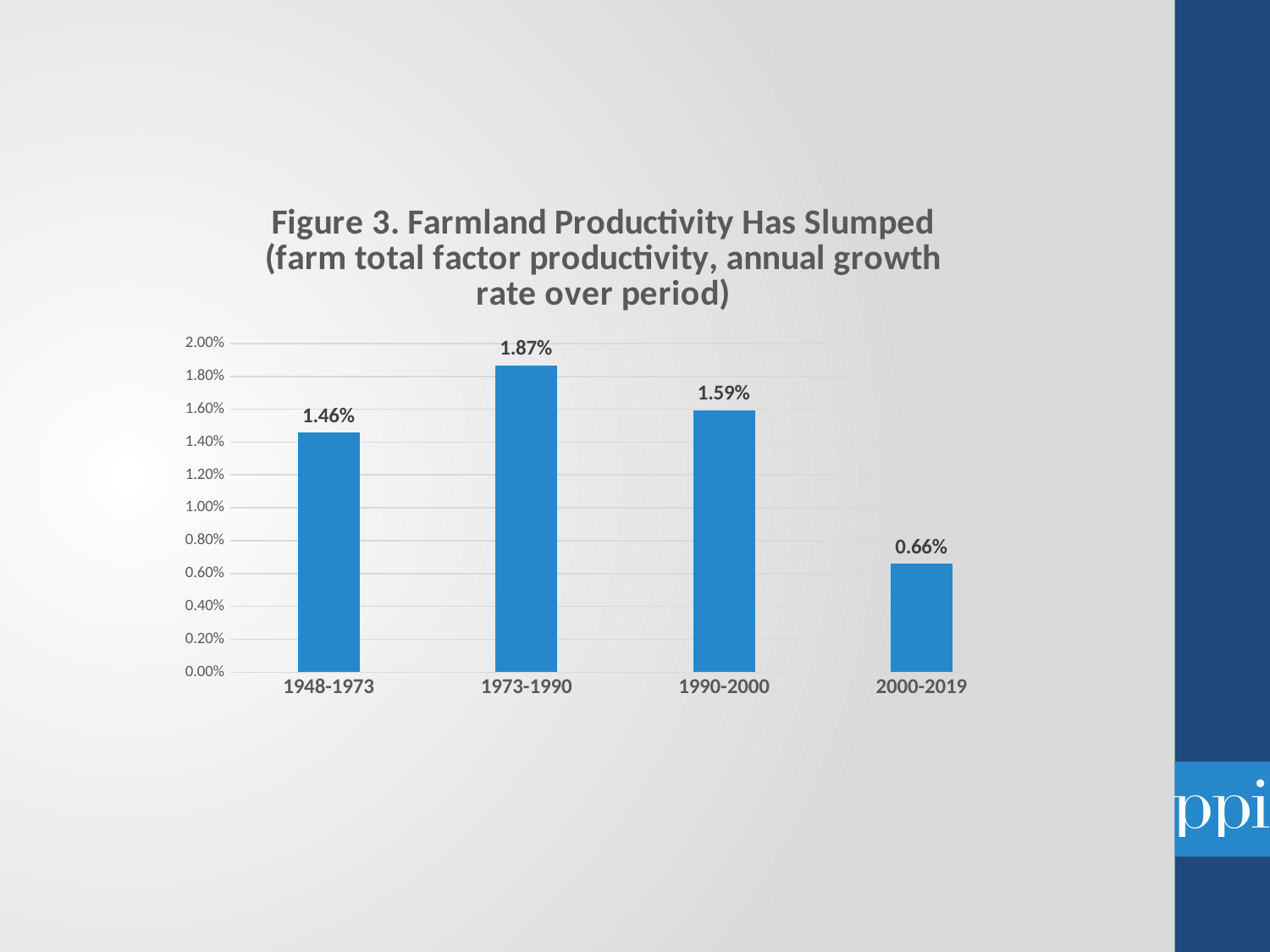
Is the value for 2000-2019 greater or less than 1.00%? less How many periods are shown on the chart? 4 What is the annual growth rate for the 1973-1990 period? 1.87% Which period has a larger growth rate, 1948-1973 or 1990-2000? 1990-2000 What is the difference between the growth rates for 1990-2000 and 1948-1973? 0.13% What is the annual growth rate for the 1948-1973 period? 1.46% What kind of chart is shown on the slide? Bar chart Which period has the lowest annual growth rate? 2000-2019 What is the title of the chart? Figure 3. Farmland Productivity Has Slumped (farm total factor productivity, annual growth rate over period) Which period has the highest annual growth rate? 1973-1990 What is the difference between the growth rates for 1973-1990 and 2000-2019? 1.21% What is the annual growth rate for the 2000-2019 period? 0.66%